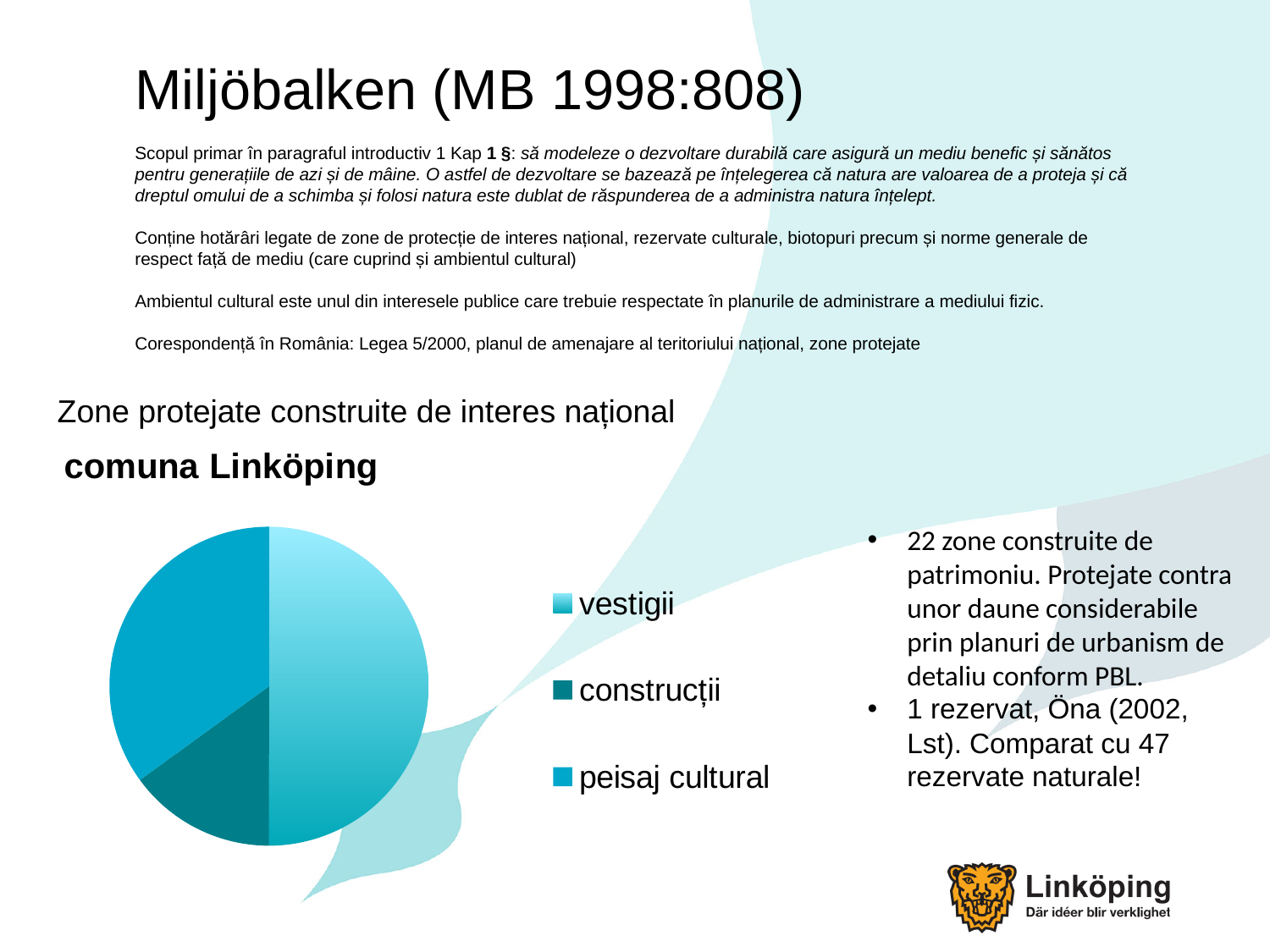
Which category has the smallest slice in the pie chart? construcții How many slices does the pie chart have? 3 Which category has the largest slice in the pie chart? vestigii How many entries does the legend of the pie chart list? 3 Which category in the pie chart is shown in the darkest teal colour? construcții Which slice is larger in the pie chart, vestigii or peisaj cultural? vestigii Which slice is larger in the pie chart, peisaj cultural or construcții? peisaj cultural What are the three categories listed in the legend of the pie chart? vestigii, construcții, peisaj cultural What kind of chart is shown on the slide? pie chart Which slice is larger in the pie chart, vestigii or construcții? vestigii